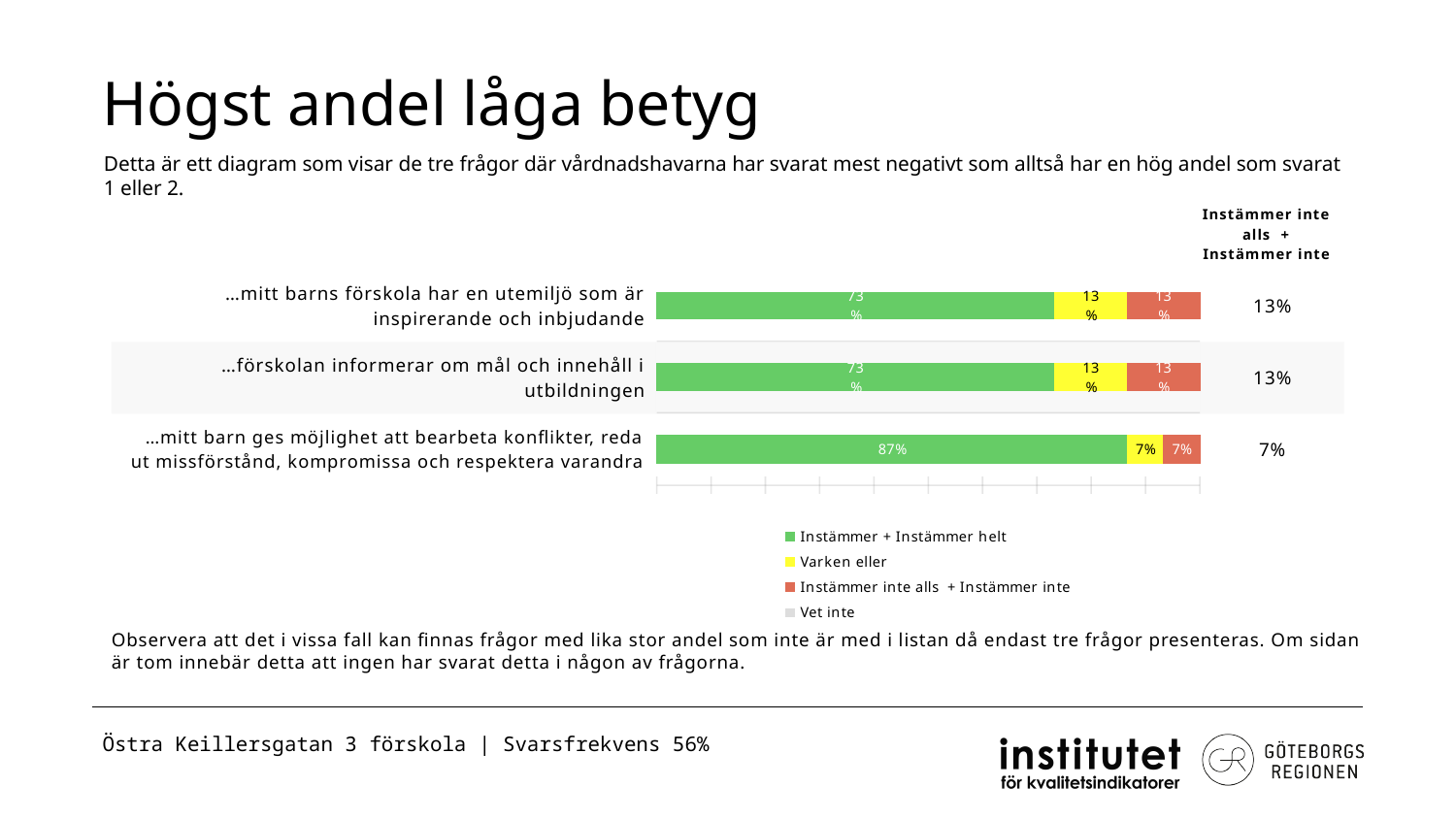
Which is larger: the 'Varken eller' value for '…mitt barns förskola har en utemiljö som är inspirerande och inbjudande' or for '…mitt barn ges möjlighet att bearbeta konflikter…'? …mitt barns förskola har en utemiljö som är inspirerande och inbjudande Which question has the highest 'Instämmer + Instämmer helt' share? …mitt barn ges möjlighet att bearbeta konflikter, reda ut missförstånd, kompromissa och respektera varandra What is the 'Instämmer + Instämmer helt' value for '…mitt barns förskola har en utemiljö som är inspirerande och inbjudande'? 73% What kind of chart is shown on the slide? stacked bar chart What is the 'Instämmer + Instämmer helt' value for '…mitt barn ges möjlighet att bearbeta konflikter, reda ut missförstånd, kompromissa och respektera varandra'? 87% What is the 'Varken eller' value for '…förskolan informerar om mål och innehåll i utbildningen'? 13% Which question has the lowest 'Instämmer inte alls + Instämmer inte' share? …mitt barn ges möjlighet att bearbeta konflikter, reda ut missförstånd, kompromissa och respektera varandra How many questions (categories) are plotted in the chart? 3 How many series does the chart legend list? 4 What is the difference between the 'Instämmer + Instämmer helt' value for '…mitt barn ges möjlighet att bearbeta konflikter…' and for '…förskolan informerar om mål och innehåll i utbildningen'? 14% Which colour represents 'Instämmer inte alls + Instämmer inte' in the chart? red/orange What is the 'Instämmer inte alls + Instämmer inte' value shown for '…mitt barn ges möjlighet att bearbeta konflikter, reda ut missförstånd, kompromissa och respektera varandra'? 7%